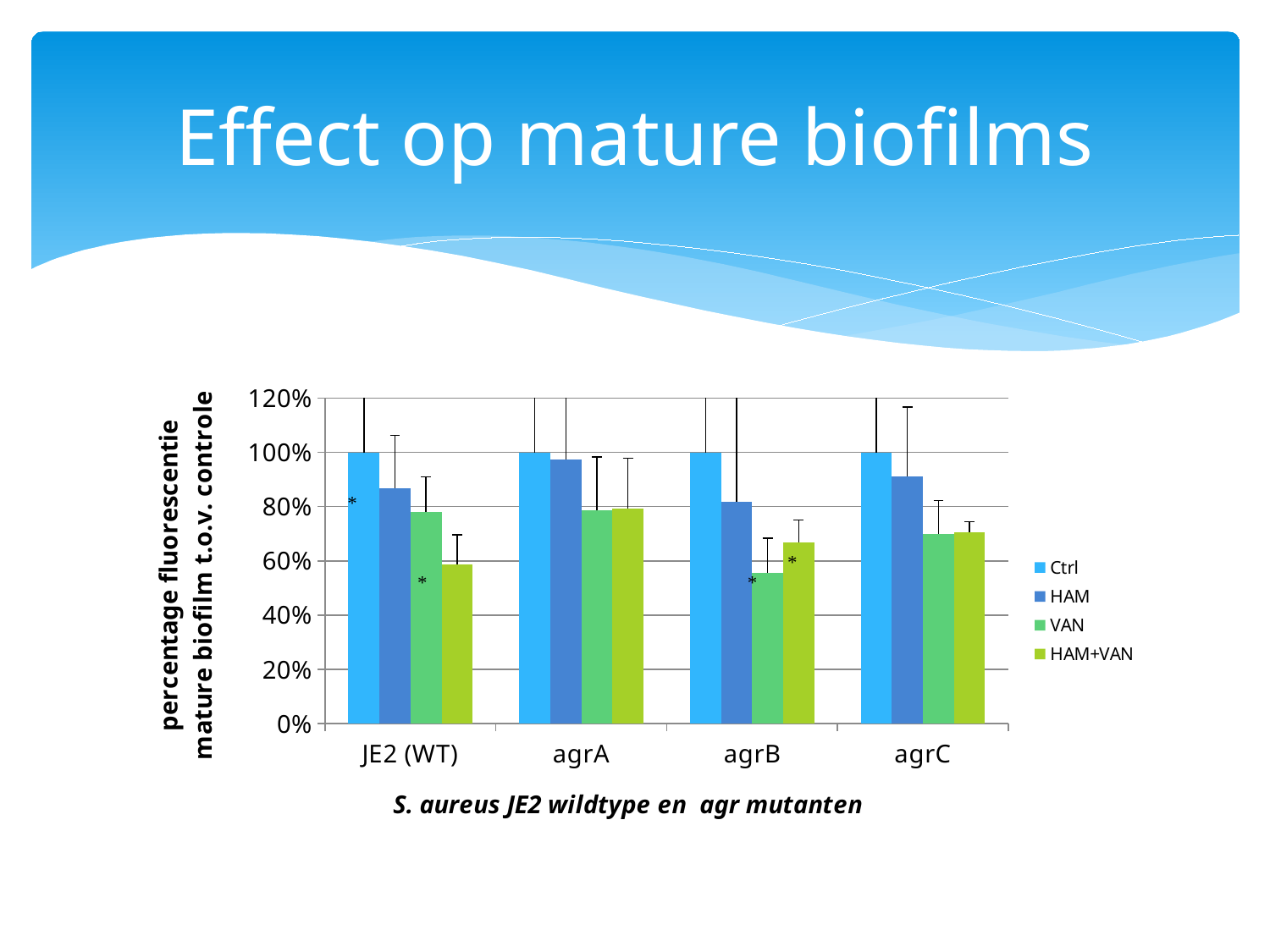
How many series does the chart's legend list? 4 Is the value of the HAM bar for agrA greater or less than 80%? greater Which series has the lowest bar in the agrB group? VAN What is the value of the Ctrl bar for JE2 (WT)? 100% What is the value of the Ctrl bar for agrC? 100% For JE2 (WT), which bar is larger: HAM or HAM+VAN? HAM What kind of chart is shown on the slide? bar chart Is the value of the VAN bar for agrC greater or less than 80%? less What is the title of the chart's x axis? S. aureus JE2 wildtype en agr mutanten How many categories are shown on the x axis of the chart? 4 Which series has the highest bar in every category group? Ctrl Is the value of the HAM+VAN bar for JE2 (WT) greater or less than 80%? less